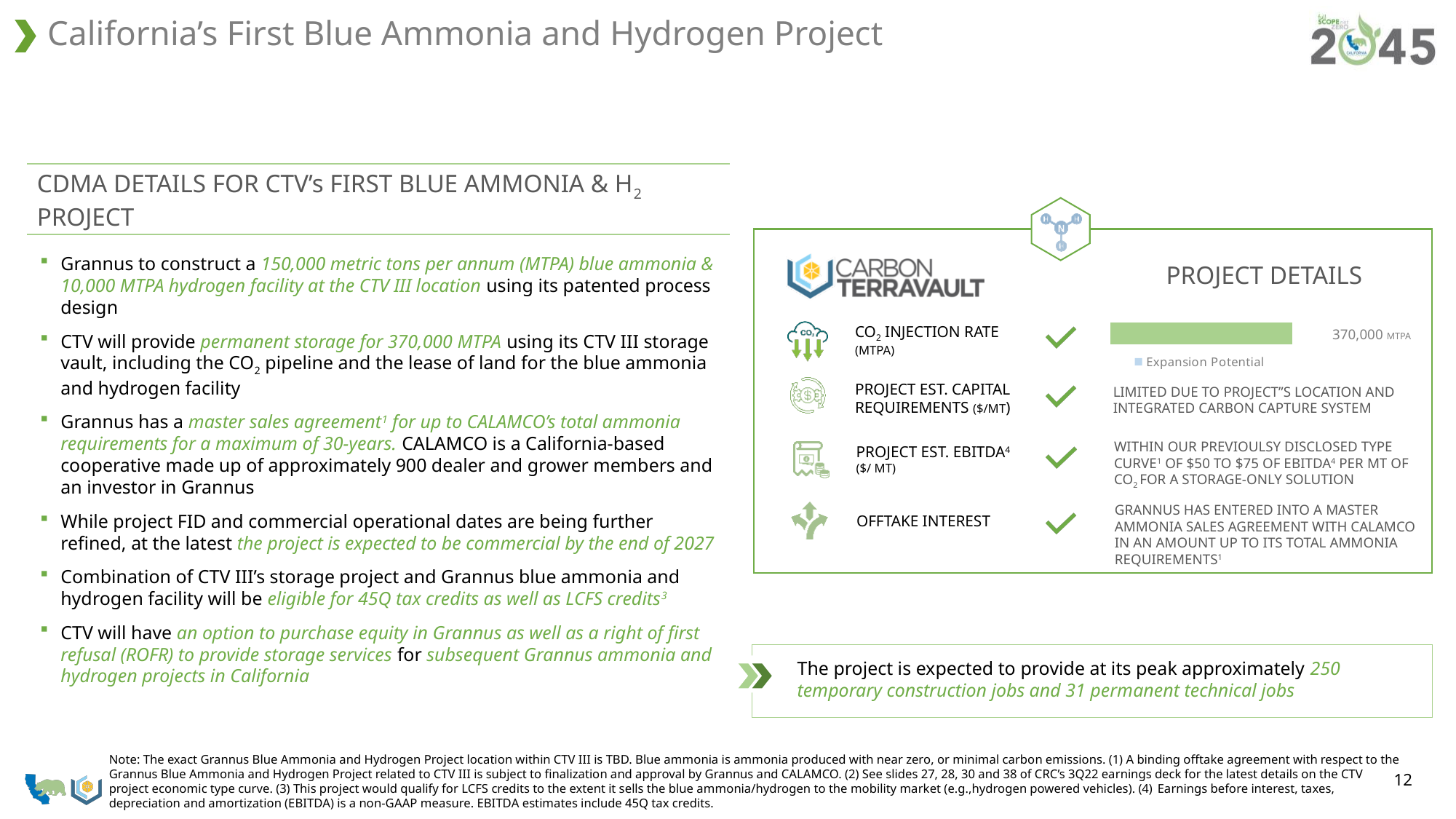
What kind of chart is used to show the CO2 injection rate? bar chart What colour is the bar in the CO2 injection rate chart? green How many series does the legend of the CO2 injection rate chart list? 1 How many bars are plotted in the CO2 injection rate chart? 1 What is the legend entry of the CO2 injection rate chart? Expansion Potential What value is shown by the bar in the CO2 injection rate chart? 370,000 MTPA What unit is shown next to the bar value in the CO2 injection rate chart? MTPA